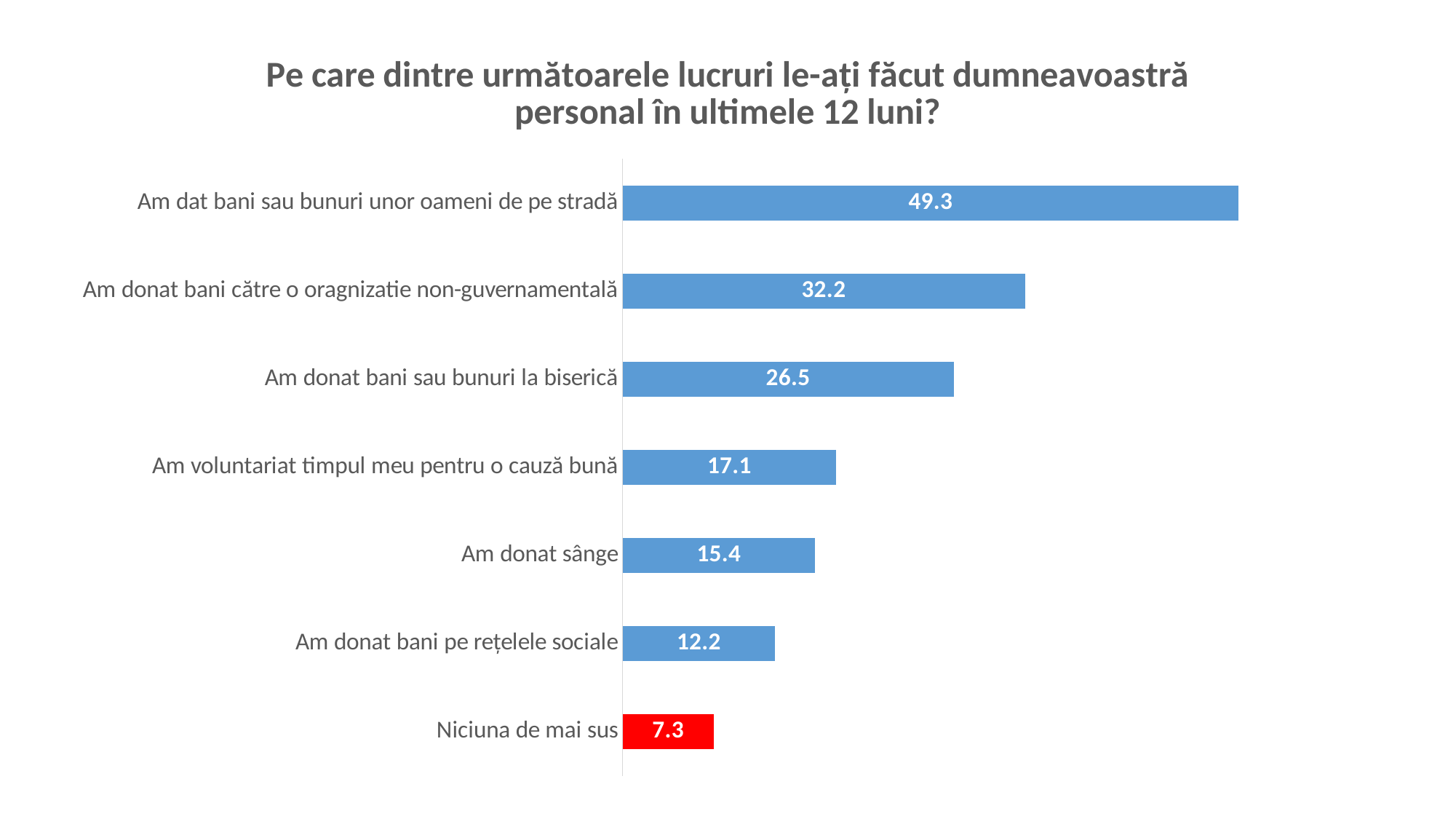
Which bar is coloured red instead of blue? Niciuna de mai sus Which category has the highest value? Am dat bani sau bunuri unor oameni de pe stradă What is the value for "Am dat bani sau bunuri unor oameni de pe stradă"? 49.3 What is the title of the chart? Pe care dintre următoarele lucruri le-ați făcut dumneavoastră personal în ultimele 12 luni? What is the value for "Am donat sânge"? 15.4 What is the difference between "Am donat bani către o oragnizatie non-guvernamentală" and "Am donat bani sau bunuri la biserică"? 5.7 Which category has the lowest value? Niciuna de mai sus What kind of chart is shown on the slide? Bar chart How many categories are shown in the chart? 7 What is the difference between "Am voluntariat timpul meu pentru o cauză bună" and "Niciuna de mai sus"? 9.8 Which is larger: the value for "Am donat sânge" or the value for "Am donat bani pe rețelele sociale"? Am donat sânge What is the value for "Am donat bani pe rețelele sociale"? 12.2